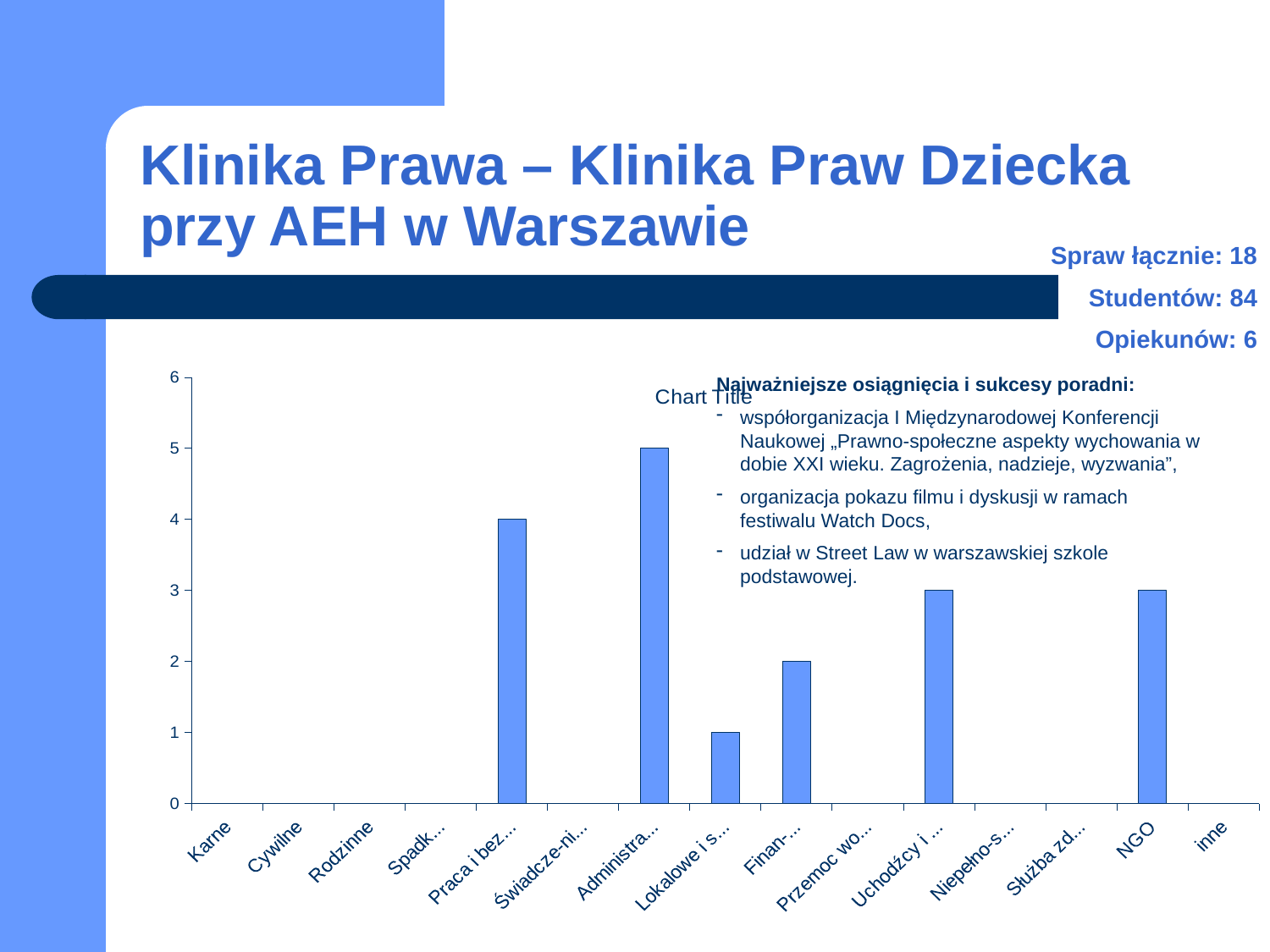
What is the value of the bar for NGO? 3 How many categories are shown on the x axis of the chart? 15 What kind of chart is shown on the slide? bar chart Which is larger, the value for NGO or the value for Finan-...? NGO What is the title shown on the chart? Chart Title What is the value of the bar for Karne? 0 What is the value of the bar for Praca i bez...? 4 Is the value for Uchodźcy i ... greater or less than 2? greater What is the value of the bar for Administra...? 5 What is the value of the bar for Finan-...? 2 Which category has the highest bar in the chart? Administra... What is the difference between the values for Administra... and Praca i bez...? 1